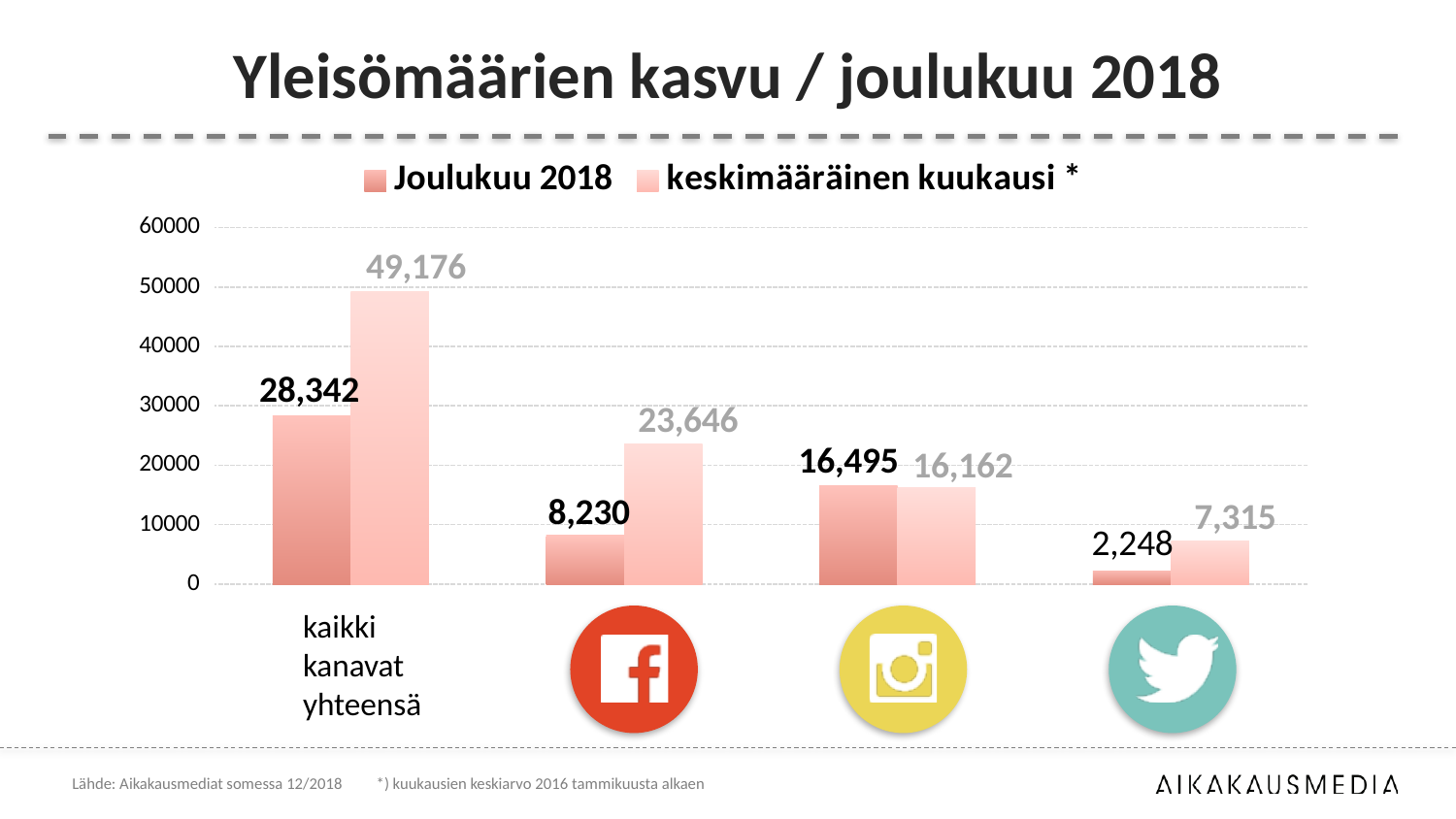
Which category has the lowest Joulukuu 2018 value? Twitter What is the keskimääräinen kuukausi value for the Twitter category? 7,315 How many categories are shown on the x axis? 4 What is the difference between the keskimääräinen kuukausi and Joulukuu 2018 values for the Facebook category? 15,416 Which category has the highest keskimääräinen kuukausi value? kaikki kanavat yhteensä For the Instagram category, which is larger: the Joulukuu 2018 value or the keskimääräinen kuukausi value? Joulukuu 2018 What is the Joulukuu 2018 value for kaikki kanavat yhteensä? 28,342 What is the Joulukuu 2018 value for the Facebook category? 8,230 How many series does the legend list? 2 What is the title of the chart? Yleisömäärien kasvu / joulukuu 2018 What kind of chart is shown on the slide? bar chart What is the keskimääräinen kuukausi value for kaikki kanavat yhteensä? 49,176